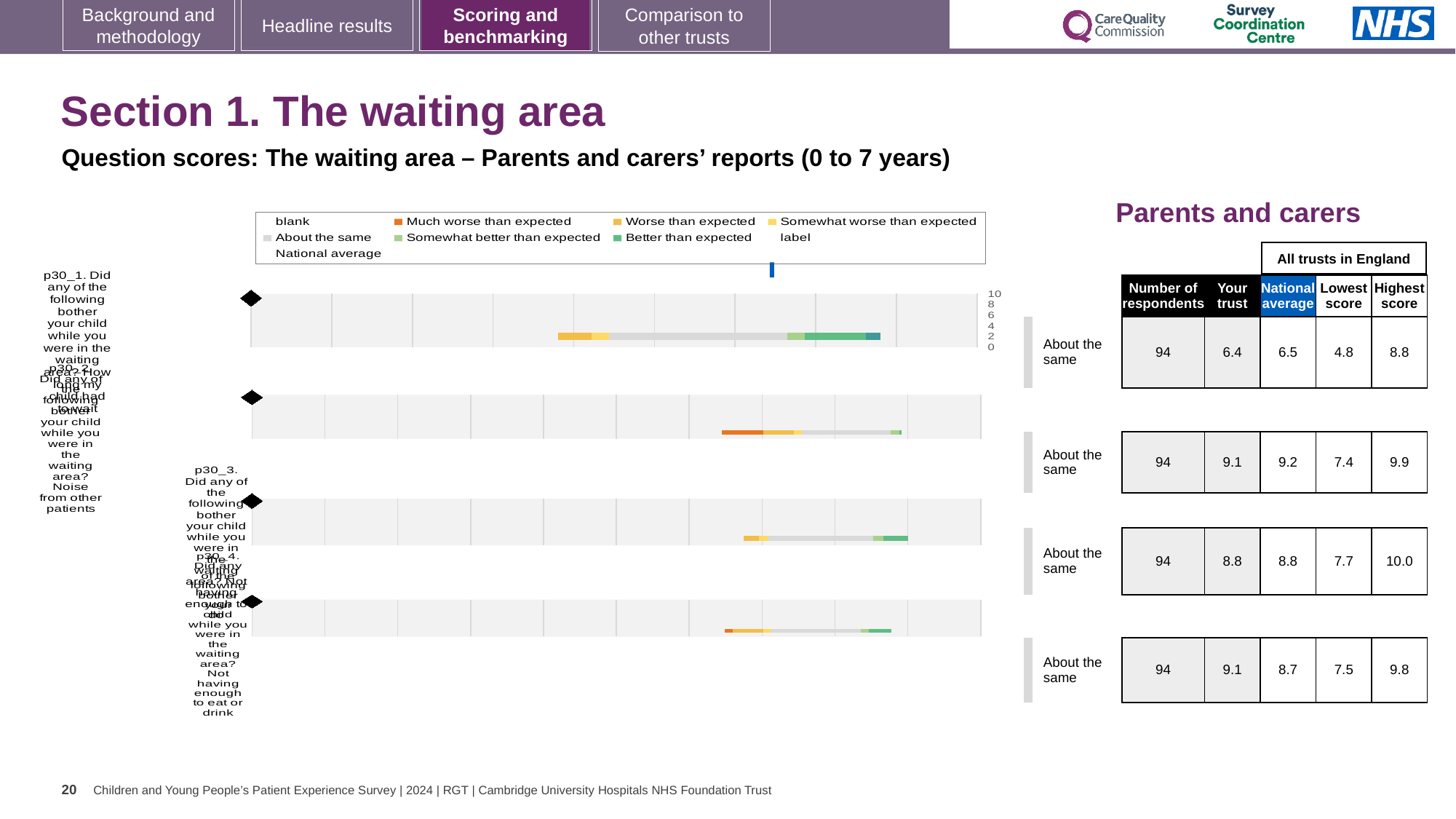
How many entries does the legend at the top of the charts list? 9 What is the benchmark category label shown to the right of the p30_2 chart (noise from other patients)? About the same How many separate bar charts are shown on the slide? 4 What is the highest tick value shown on the axis of the first chart (p30_1)? 10 Which legend entry is shown in orange? Much worse than expected What kind of chart is used for the p30_1 question about the waiting area? Bar chart